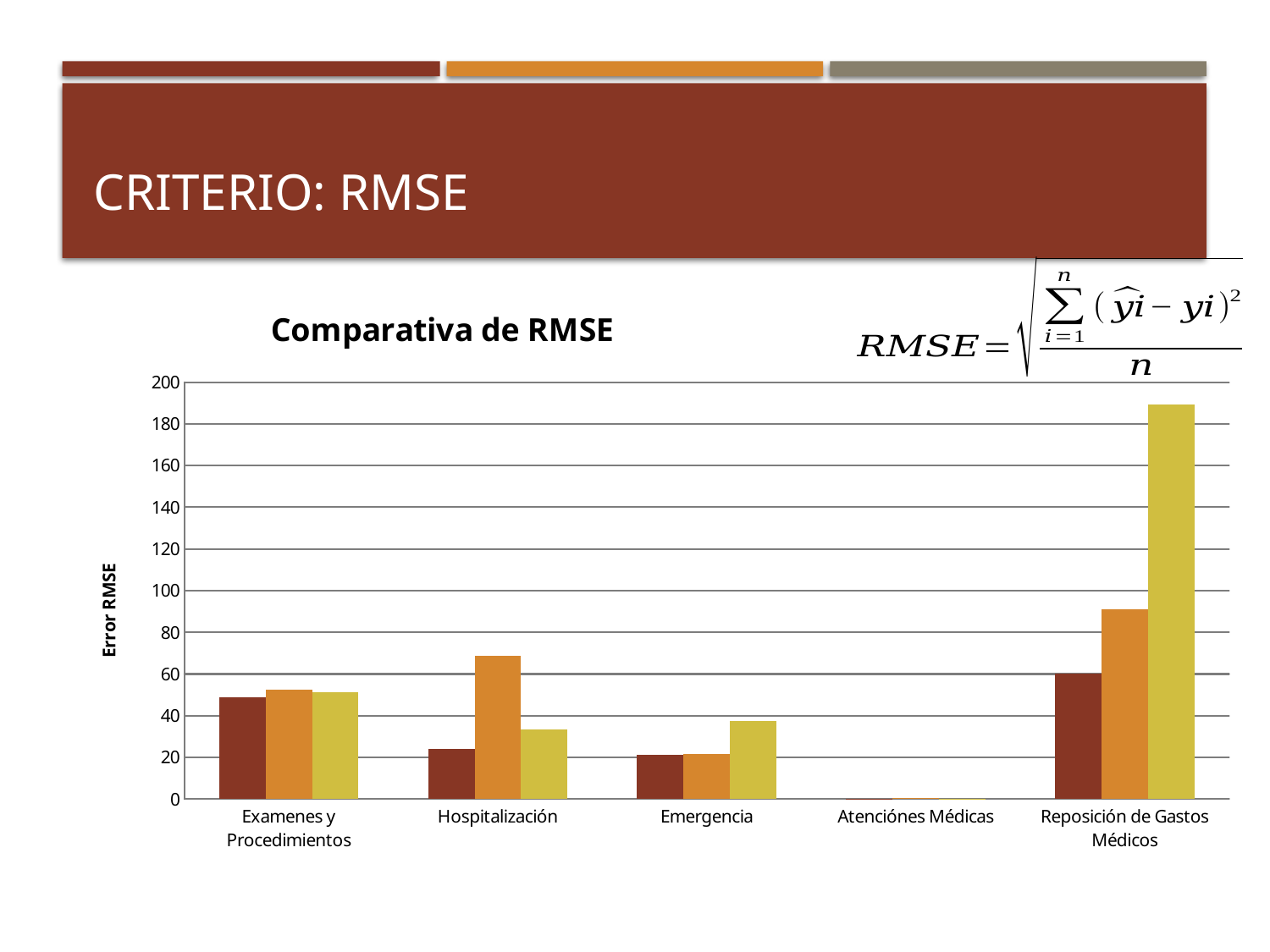
What type of chart is shown on the slide? bar chart Is the value of the orange bar for Hospitalización greater or less than 60? greater What is the title of the chart? Comparativa de RMSE How many categories are shown on the x axis of the chart? 5 Is the value of the orange bar for Reposición de Gastos Médicos greater or less than 100? less Is the value of the dark red bar for Hospitalización greater or less than 40? less What is the label on the vertical axis of the chart? Error RMSE Which is larger: the orange bar for Hospitalización or the orange bar for Emergencia? Hospitalización Which category has the lowest bars in the chart? Atenciónes Médicas Which category contains the tallest bar in the chart? Reposición de Gastos Médicos Which is larger: the yellow bar for Emergencia or the dark red bar for Emergencia? the yellow bar